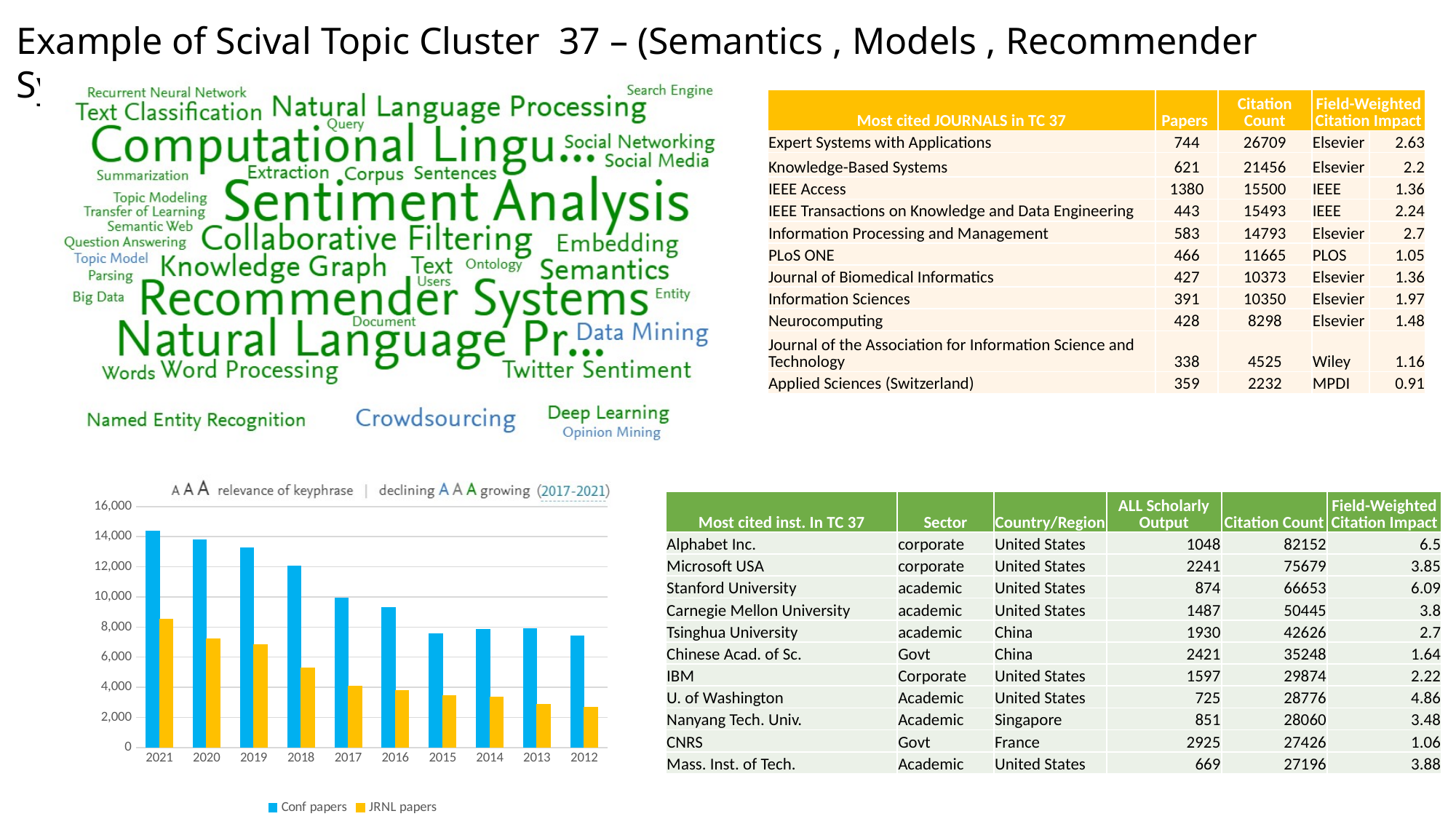
In the bar chart, is the value for JRNL papers in 2021 greater or less than 8,000? greater In the bar chart, is the value for JRNL papers in 2018 greater or less than 4,000? greater In the bar chart, is the value for Conf papers in 2016 greater or less than 10,000? less What kind of chart is shown at the bottom left of the slide? bar chart How many series does the legend of the bar chart list? 2 In the bar chart, what colour are the Conf papers bars? blue In the bar chart, which year has the highest value for JRNL papers? 2021 In the bar chart, which is larger in 2019: Conf papers or JRNL papers? Conf papers How many years are shown on the x axis of the bar chart? 10 In the bar chart, which year has the highest value for Conf papers? 2021 In the bar chart, do the JRNL papers values generally rise or fall moving along the x axis from 2021 to 2012? fall